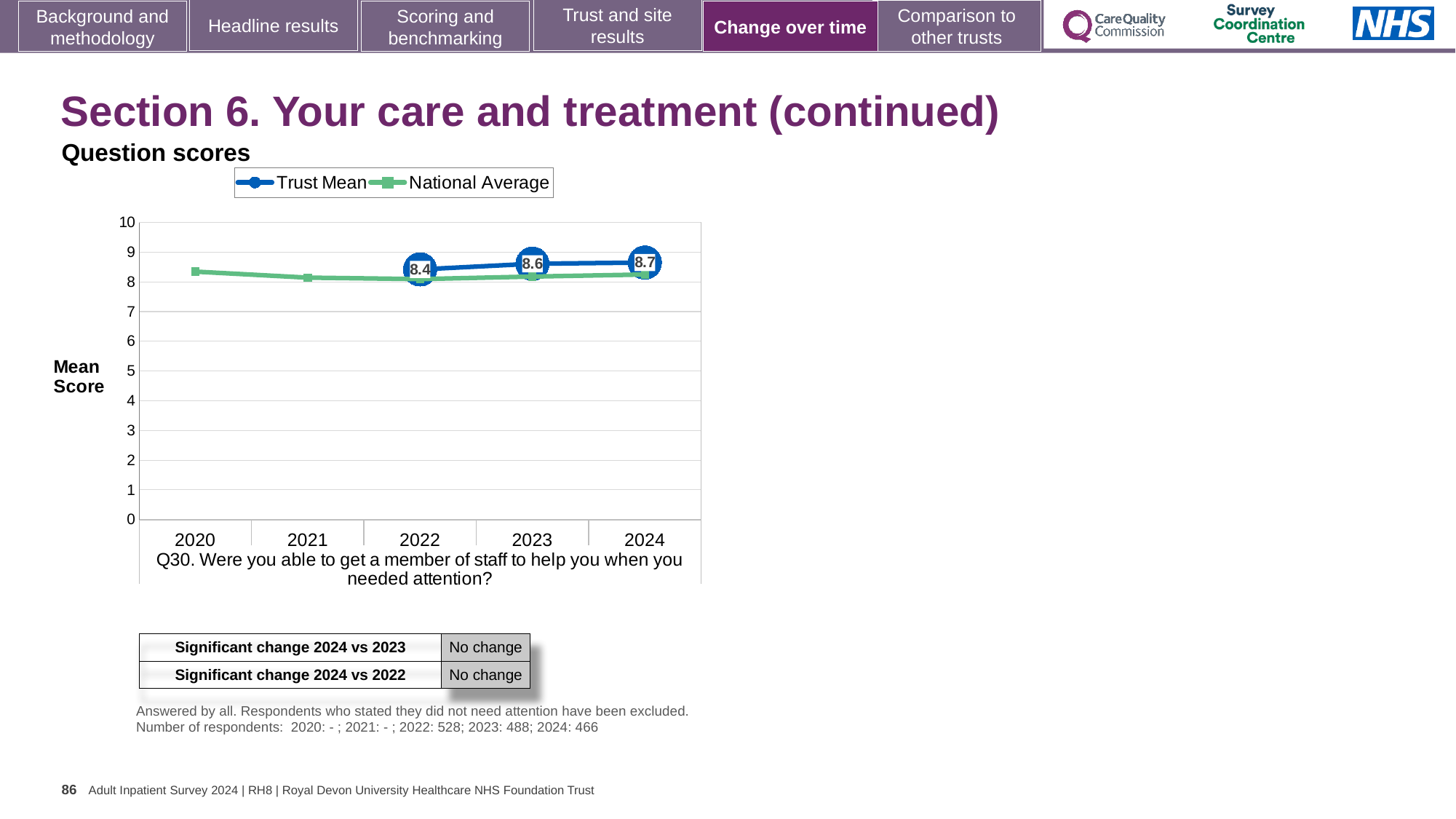
In 2024, which is higher: the Trust Mean or the National Average? Trust Mean Does the Trust Mean rise or fall from 2022 to 2024? Rise Is the National Average value for 2021 greater or less than 9? less In which year is the Trust Mean score highest? 2024 What kind of chart is shown on the slide? Line chart How many years are shown on the x axis? 5 In which year is the Trust Mean score lowest among the years with a plotted Trust Mean? 2022 What is the Trust Mean score for 2023? 8.6 What is the difference between the Trust Mean score in 2024 and in 2022? 0.3 How many series does the legend list? 2 What is the Trust Mean score for 2022? 8.4 What is the Trust Mean score for 2024? 8.7